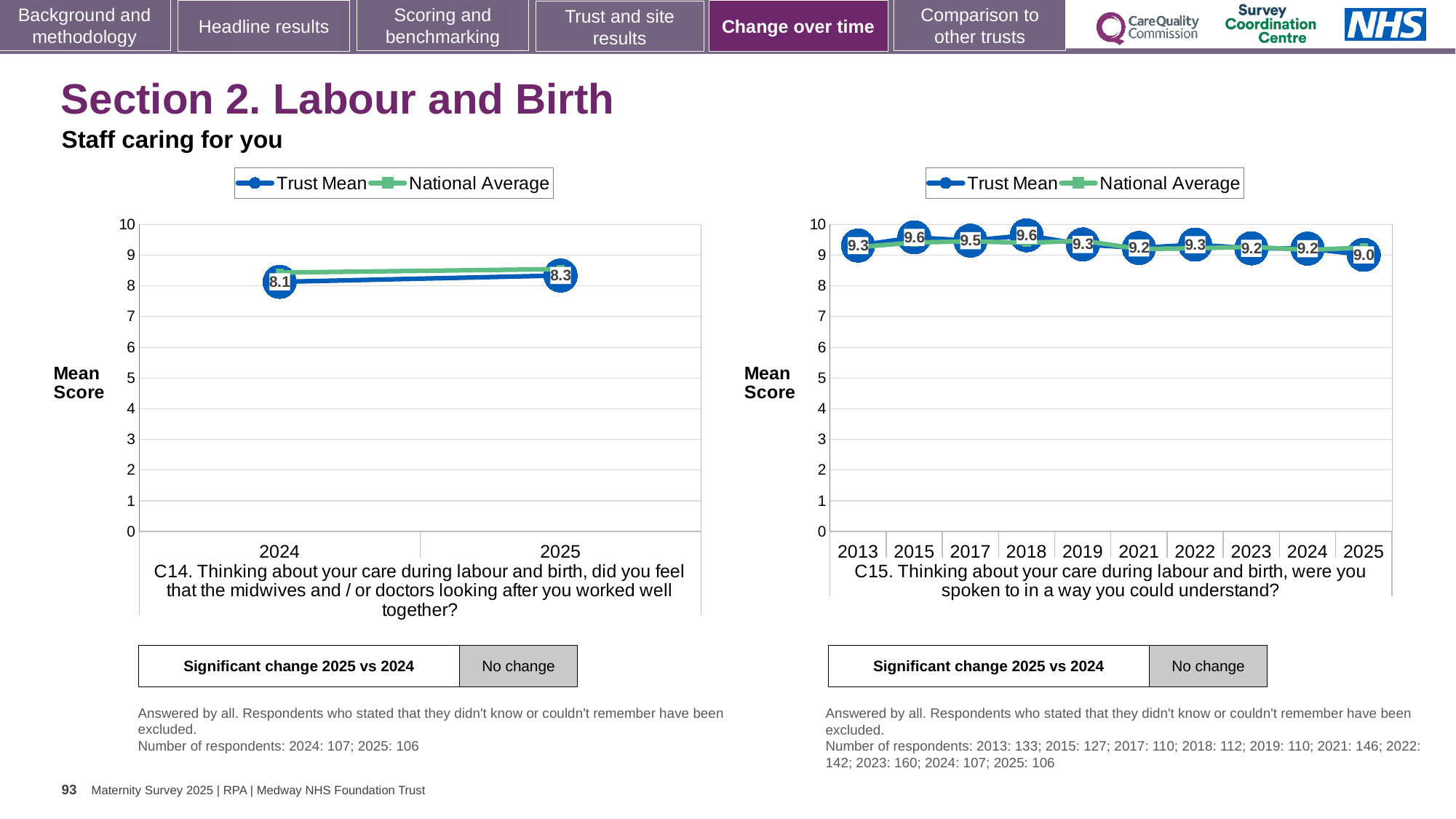
In the C14 chart on the left, does the Trust Mean rise or fall from 2024 to 2025? rise In the C14 chart on the left, how many series does the legend list? 2 In the C15 chart on the right, what is the Trust Mean score for 2013? 9.3 In the C15 chart on the right, which year has the lowest Trust Mean score? 2025 In the C15 chart on the right, how many years are plotted on the x axis? 10 In the C14 chart on the left, by how much did the Trust Mean change from 2024 to 2025? 0.2 In the C15 chart on the right, what is the Trust Mean score for 2025? 9.0 In the C14 chart on the left, what is the Trust Mean score for 2024? 8.1 In the C14 chart on the left, what is the Trust Mean score for 2025? 8.3 What type of chart is the C15 chart on the right? line chart In the C15 chart on the right, is the Trust Mean for 2015 or for 2021 higher? 2015 In the C15 chart on the right, what is the difference between the Trust Mean in 2018 and in 2025? 0.6